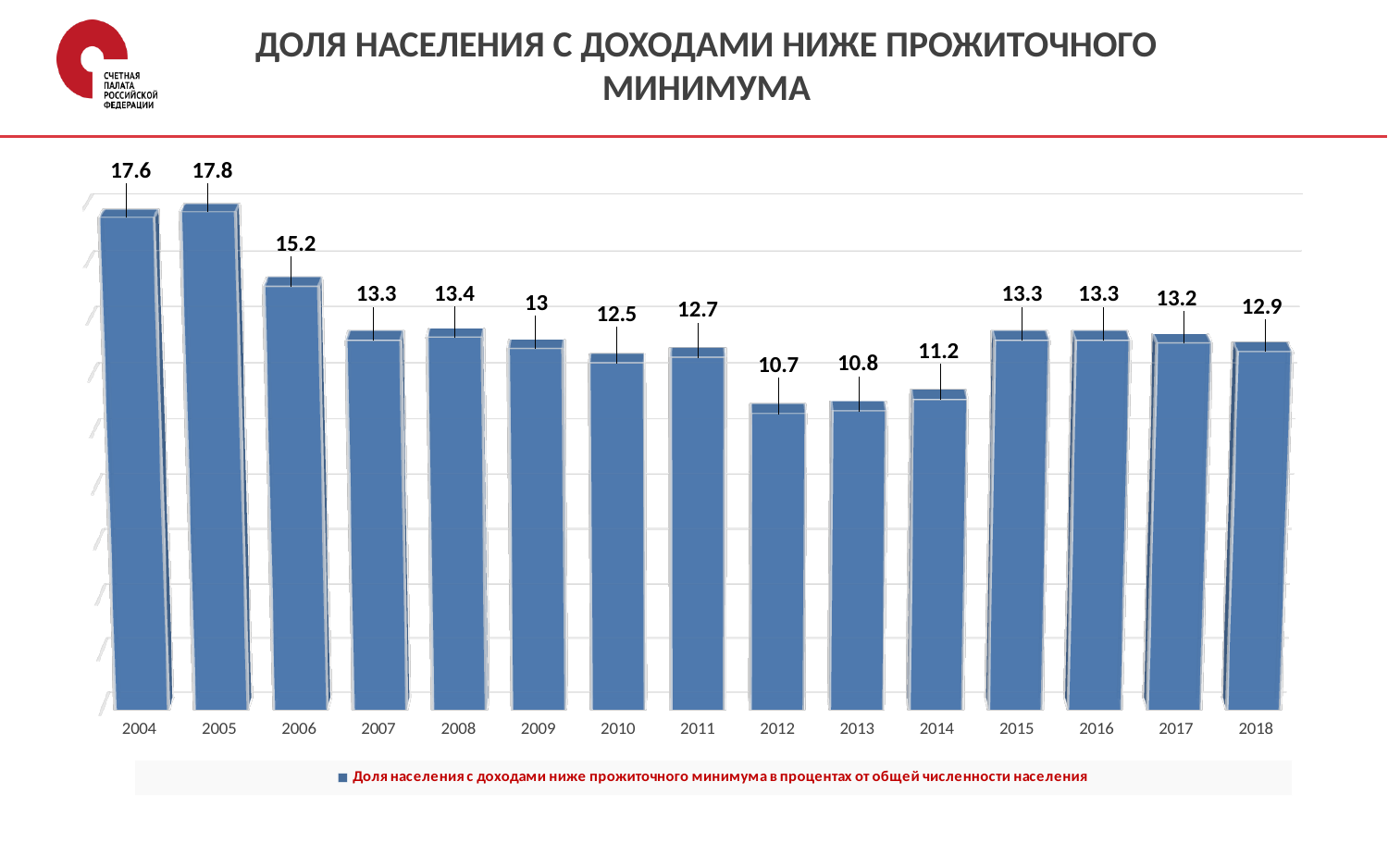
Which year has the lowest value? 2012 Which year has the highest value? 2005 Which is larger, the value for 2006 or the value for 2014? 2006 How many years are shown on the x axis? 15 What is the value for 2018? 12.9 What kind of chart is shown on the slide? bar chart What is the title of the chart? ДОЛЯ НАСЕЛЕНИЯ С ДОХОДАМИ НИЖЕ ПРОЖИТОЧНОГО МИНИМУМА What is the difference between the values for 2005 and 2012? 7.1 Do the values rise or fall from 2004 to 2012? fall What is the value for 2004? 17.6 How many series does the legend list? 1 What is the value for 2012? 10.7